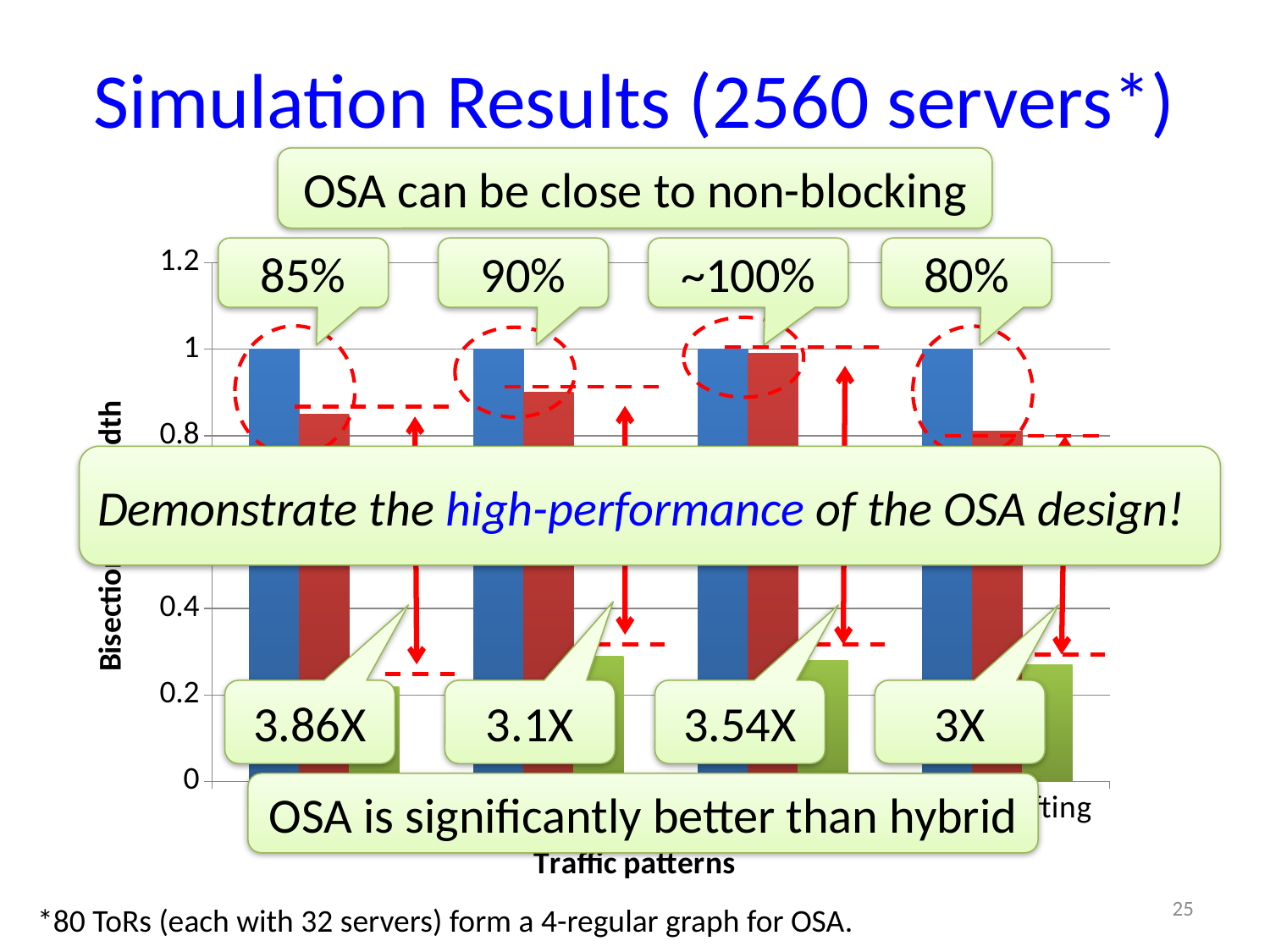
How many groups of bars (traffic patterns) are plotted along the x axis? 4 Is the value of the blue bar in the first group greater or less than 0.8? greater Is the value of the red bar in the second group greater or less than 0.8? greater How many bars are there in each group? 3 Is the value of the green bar in the third group greater or less than 0.4? less In the fourth group, which bar is taller, the red bar or the green bar? red bar What percentage is shown in the callout above the third group of bars? ~100% What kind of chart is shown on the slide? bar chart Which bar is the shortest in the second group? green bar What is the title of the x axis? Traffic patterns In the first group, which bar is taller, the blue bar or the green bar? blue bar